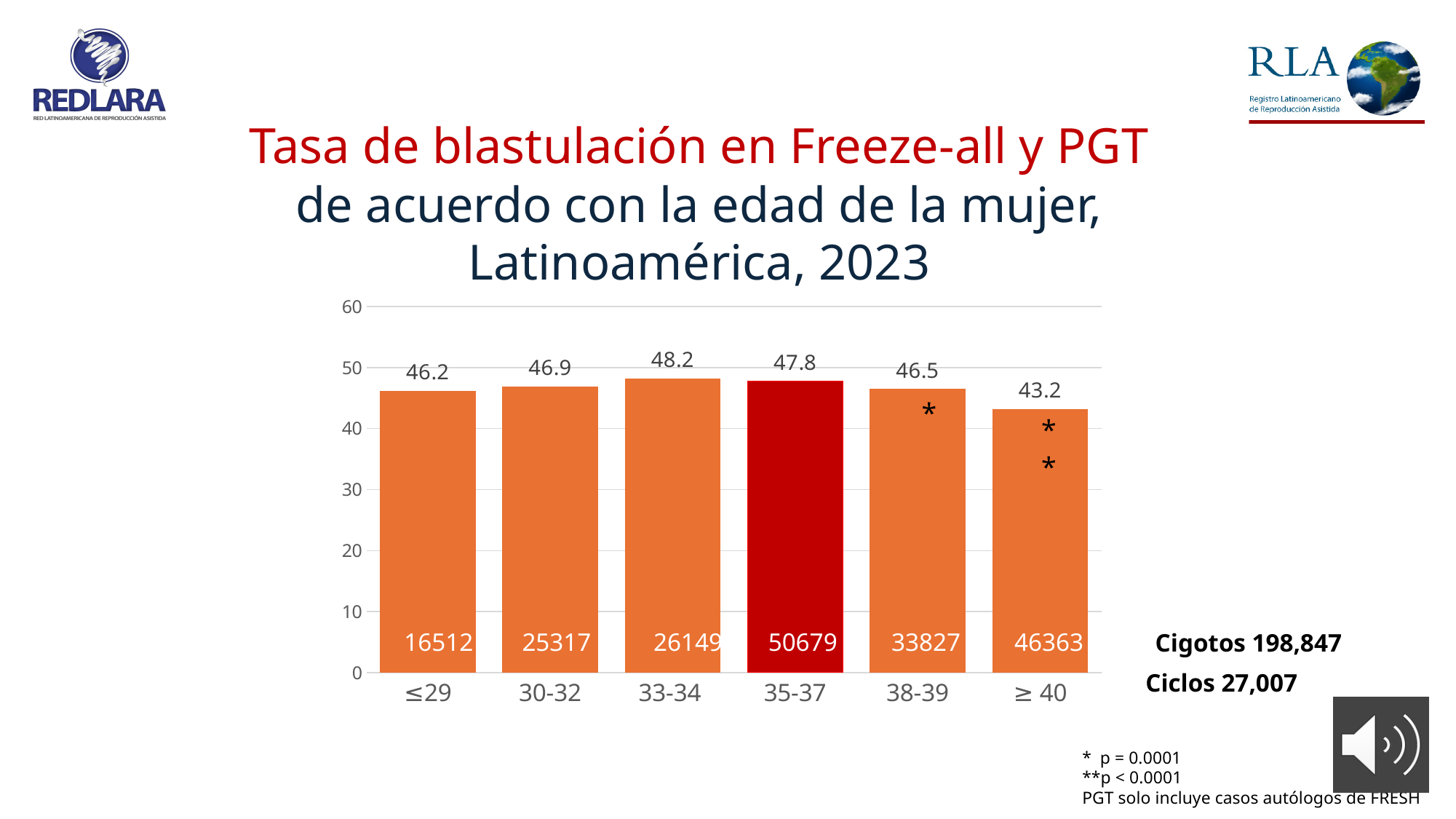
What is the difference between the blastulation rates of the 33-34 and ≥ 40 age groups? 5.0 What kind of chart is shown on the slide? bar chart Which has a higher blastulation rate, the 30-32 group or the 38-39 group? 30-32 Which bar is coloured dark red instead of orange? 35-37 What number of zygotes is printed inside the bar for the 35-37 age group? 50679 What is the blastulation rate for the 33-34 age group? 48.2 How many age groups are shown on the chart? 6 Which age group has the lowest blastulation rate? ≥ 40 What is the blastulation rate for the ≥ 40 age group? 43.2 Is the value for the ≤29 age group greater or less than 40? greater What is the total number of zygotes (Cigotos) stated next to the chart? 198,847 Which age group has the highest blastulation rate? 33-34